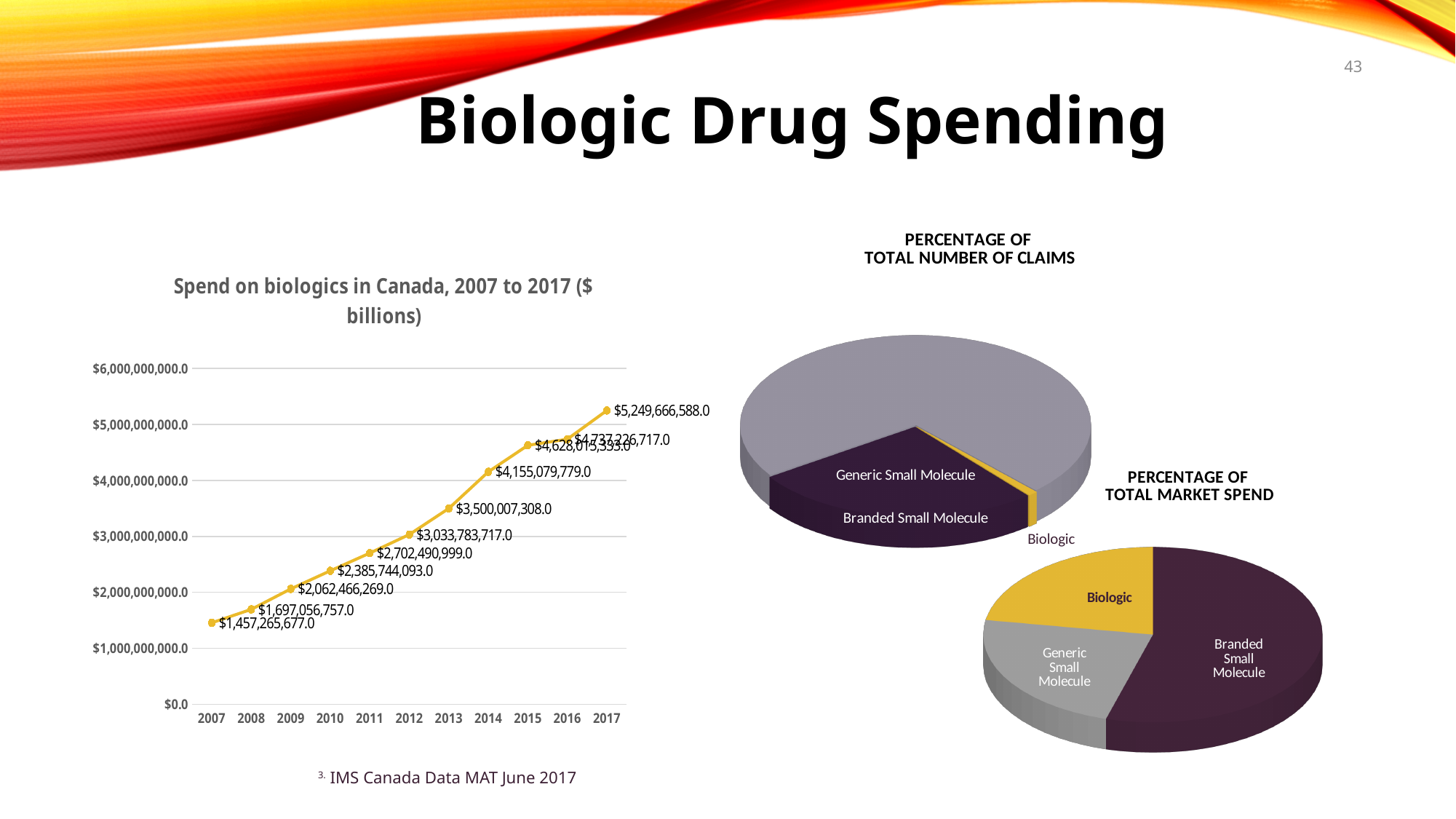
In the 'Percentage of Total Number of Claims' pie chart, which category has the largest slice? Generic Small Molecule In the 'Spend on biologics in Canada, 2007 to 2017' chart, what is the value for 2007? $1,457,265,677.0 In the 'Spend on biologics in Canada, 2007 to 2017' chart, which year has the lowest spend? 2007 In the 'Spend on biologics in Canada, 2007 to 2017' chart, what is the value for 2013? $3,500,007,308.0 In the 'Spend on biologics in Canada, 2007 to 2017' chart, is the value for 2010 greater or less than $3,000,000,000.0? less What kind of chart is 'Spend on biologics in Canada, 2007 to 2017'? line chart In the 'Spend on biologics in Canada, 2007 to 2017' chart, which year has the highest spend? 2017 In the 'Spend on biologics in Canada, 2007 to 2017' chart, do the values rise or fall from 2007 to 2017? rise In the 'Spend on biologics in Canada, 2007 to 2017' chart, what is the difference between the 2017 and 2007 values? $3,792,400,911.0 In the 'Percentage of Total Market Spend' pie chart, which category has the largest slice? Branded Small Molecule In the 'Spend on biologics in Canada, 2007 to 2017' chart, what is the value for 2017? $5,249,666,588.0 In the 'Spend on biologics in Canada, 2007 to 2017' chart, how many years are plotted? 11